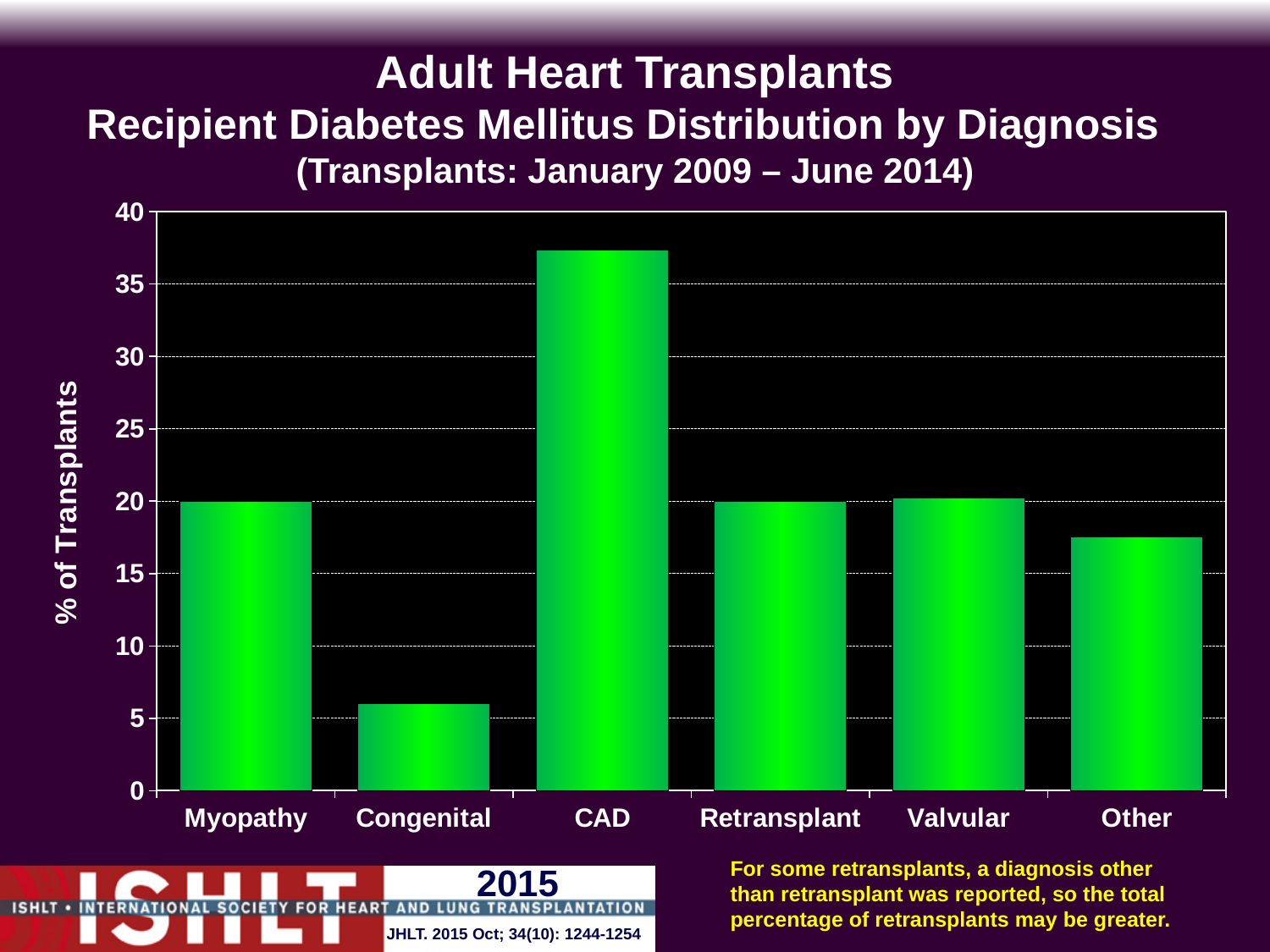
Which is larger, the value for CAD or the value for Myopathy? CAD Which diagnosis category has the lowest % of transplants? Congenital Which is larger, the value for Other or the value for Congenital? Other Is the value for Other greater or less than 20? less What kind of chart is shown on the slide? bar chart Which diagnosis category has the highest % of transplants? CAD Is the value for CAD greater or less than 35? greater Is the value for Retransplant greater or less than 25? less What is the label on the y axis of the chart? % of Transplants How many diagnosis categories are shown on the x axis? 6